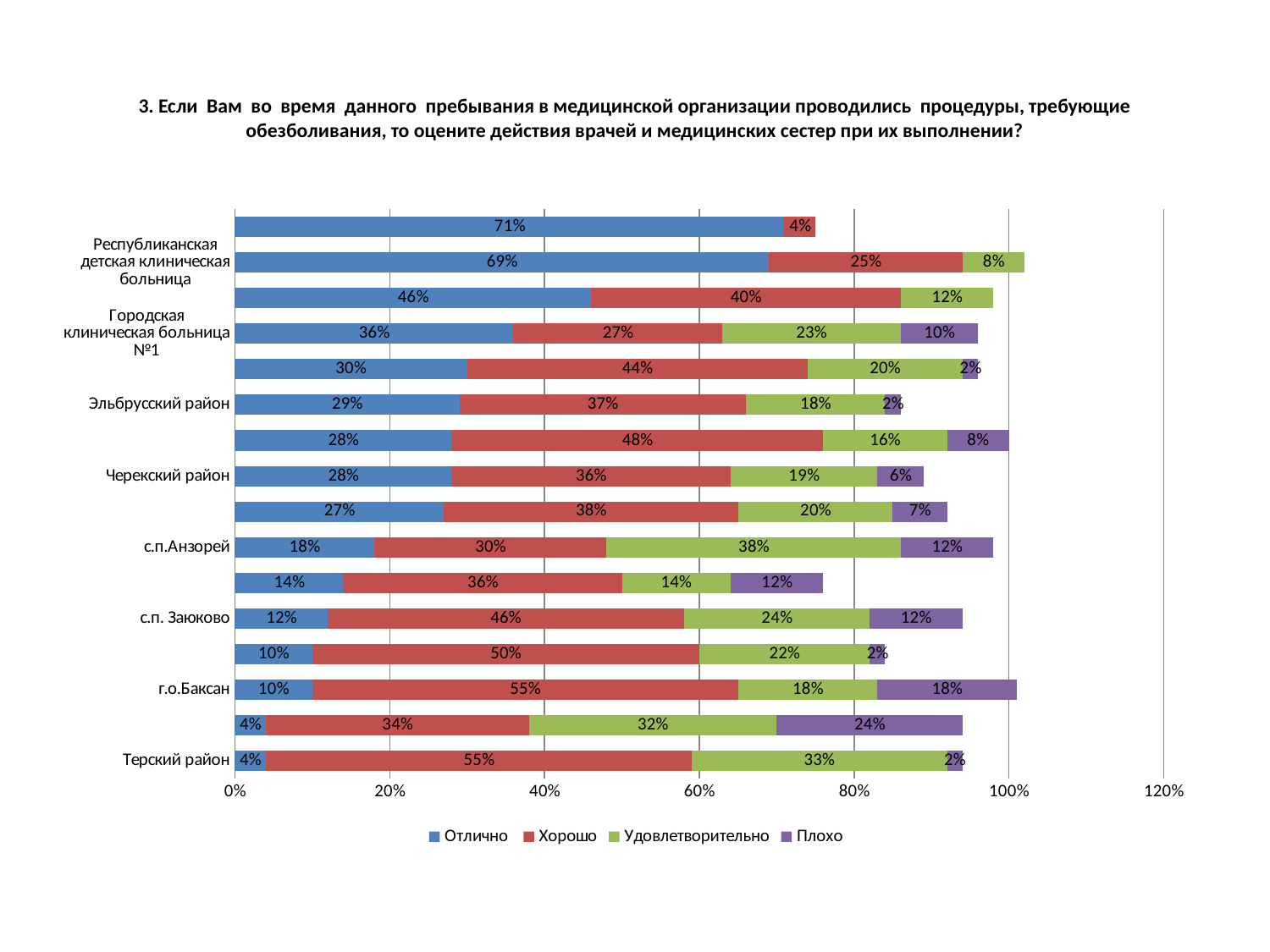
How many series does the legend list? 4 For Эльбрусский район, how much larger is the "Хорошо" value than the "Отлично" value? 8 percentage points What is the "Хорошо" value for Республиканская детская клиническая больница? 25% What percentage of respondents rated Терский район as "Хорошо"? 55% What is the total of the stacked bar for Черекский район? 89% Which rating category has the largest share for Терский район? Хорошо Is the "Отлично" value for с.п. Заюково greater or less than 20%? less Which has a higher "Отлично" value: Городская клиническая больница №1 or Черекский район? Городская клиническая больница №1 What is the "Плохо" value for г.о.Баксан? 18% What is the "Отлично" value for Городская клиническая больница №1? 36% What is the "Удовлетворительно" value for с.п.Анзорей? 38% What kind of chart is shown on the slide? Stacked bar chart